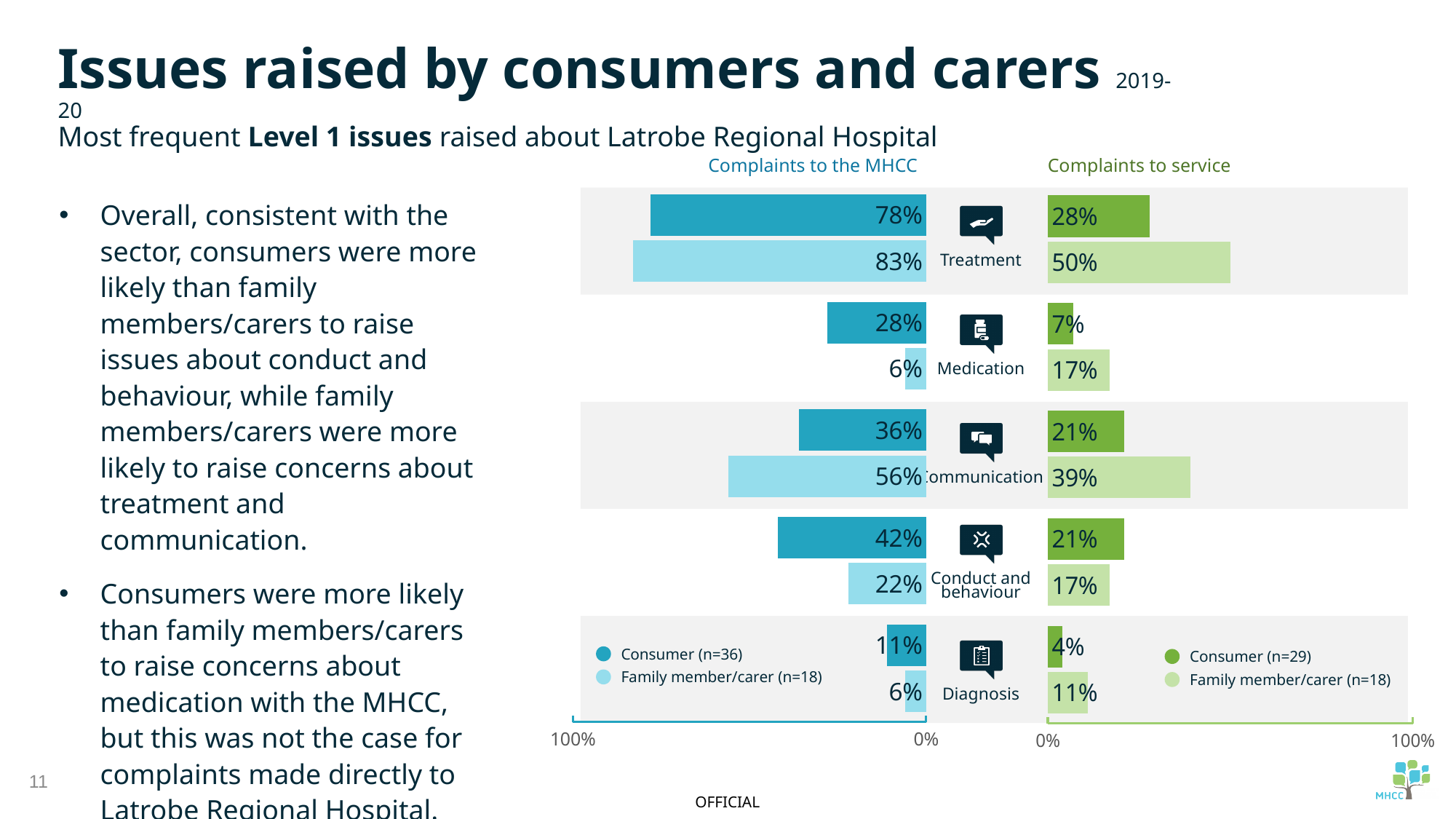
In the 'Complaints to service' chart, what is the difference between the family member/carer and consumer percentages for Communication? 18% In the 'Complaints to the MHCC' chart, which is larger for Conduct and behaviour: the consumer percentage or the family member/carer percentage? Consumer How many series does the legend of the 'Complaints to service' chart list? 2 In the 'Complaints to service' chart, what percentage of family members/carers raised issues about Treatment? 50% How many issue categories are shown in the 'Complaints to the MHCC' chart? 5 In the 'Complaints to the MHCC' chart, what is the difference between the consumer and family member/carer percentages for Medication? 22% In the 'Complaints to service' chart, which issue has the lowest percentage for consumers? Diagnosis In the 'Complaints to service' chart, what percentage of consumers raised issues about Diagnosis? 4% In the 'Complaints to the MHCC' chart, which issue has the highest percentage for consumers? Treatment In the 'Complaints to the MHCC' chart, what percentage of consumers raised issues about Treatment? 78% In the 'Complaints to the MHCC' chart, what percentage of family members/carers raised issues about Communication? 56% What type of chart is the 'Complaints to service' chart? Bar chart